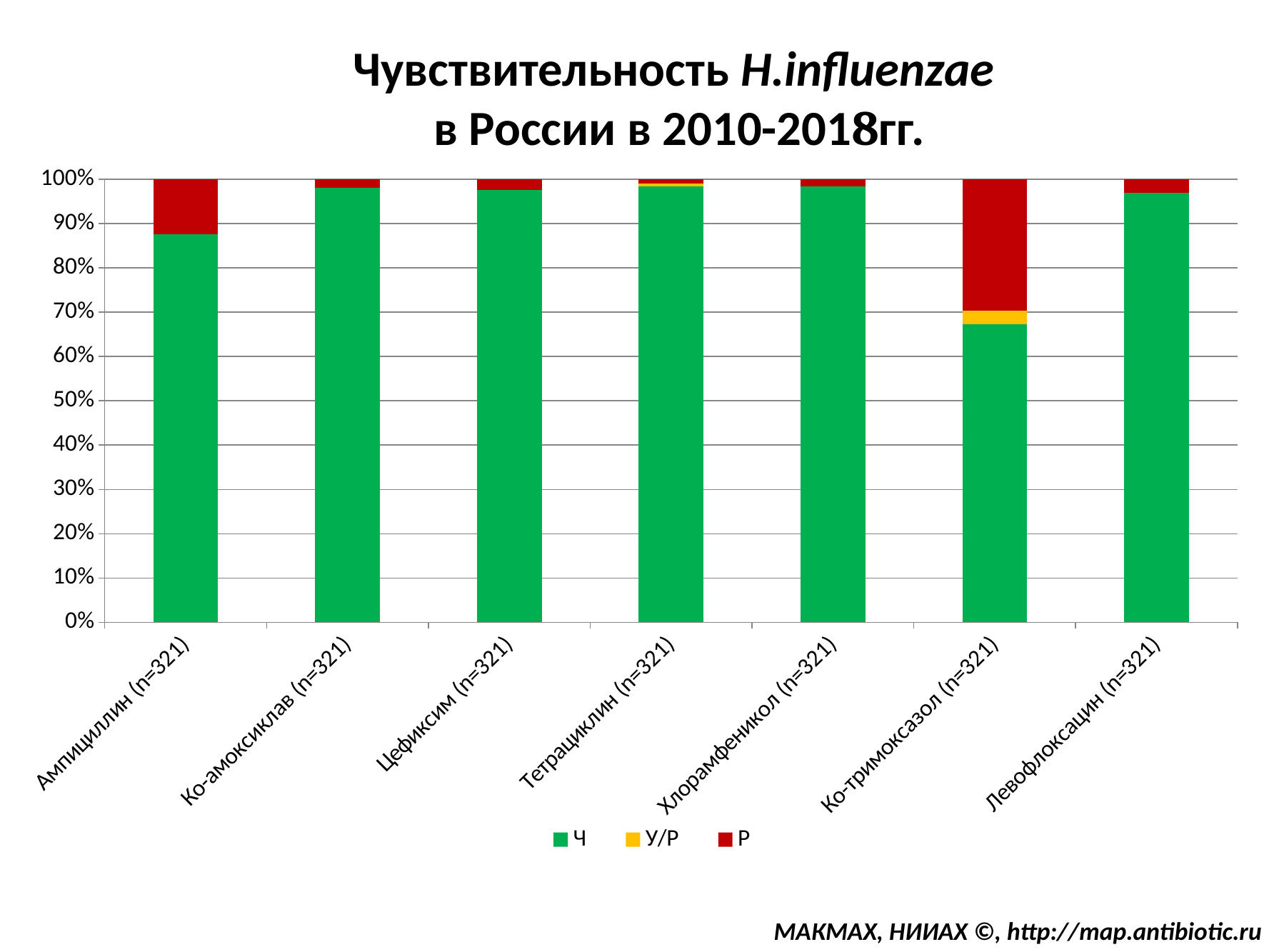
What is the total height of the stacked bar for Ампициллин (n=321)? 100% How many series does the legend list? 3 Which has the larger Р segment: Ампициллин (n=321) or Левофлоксацин (n=321)? Ампициллин (n=321) Is the Р segment for Ко-тримоксазол (n=321) greater or less than 20%? greater Which antibiotic has the largest Р (red) segment? Ко-тримоксазол (n=321) What colour represents the У/Р series in the legend? Yellow How many antibiotics (categories) are shown on the x axis? 7 Which antibiotic has the lowest value for the Ч series? Ко-тримоксазол (n=321) Is the Ч value for Ко-тримоксазол (n=321) greater or less than 70%? less Which has the larger Ч value: Ампициллин (n=321) or Ко-тримоксазол (n=321)? Ампициллин (n=321) What kind of chart is shown on the slide? Stacked bar chart Is the Ч value for Ампициллин (n=321) greater or less than 90%? less